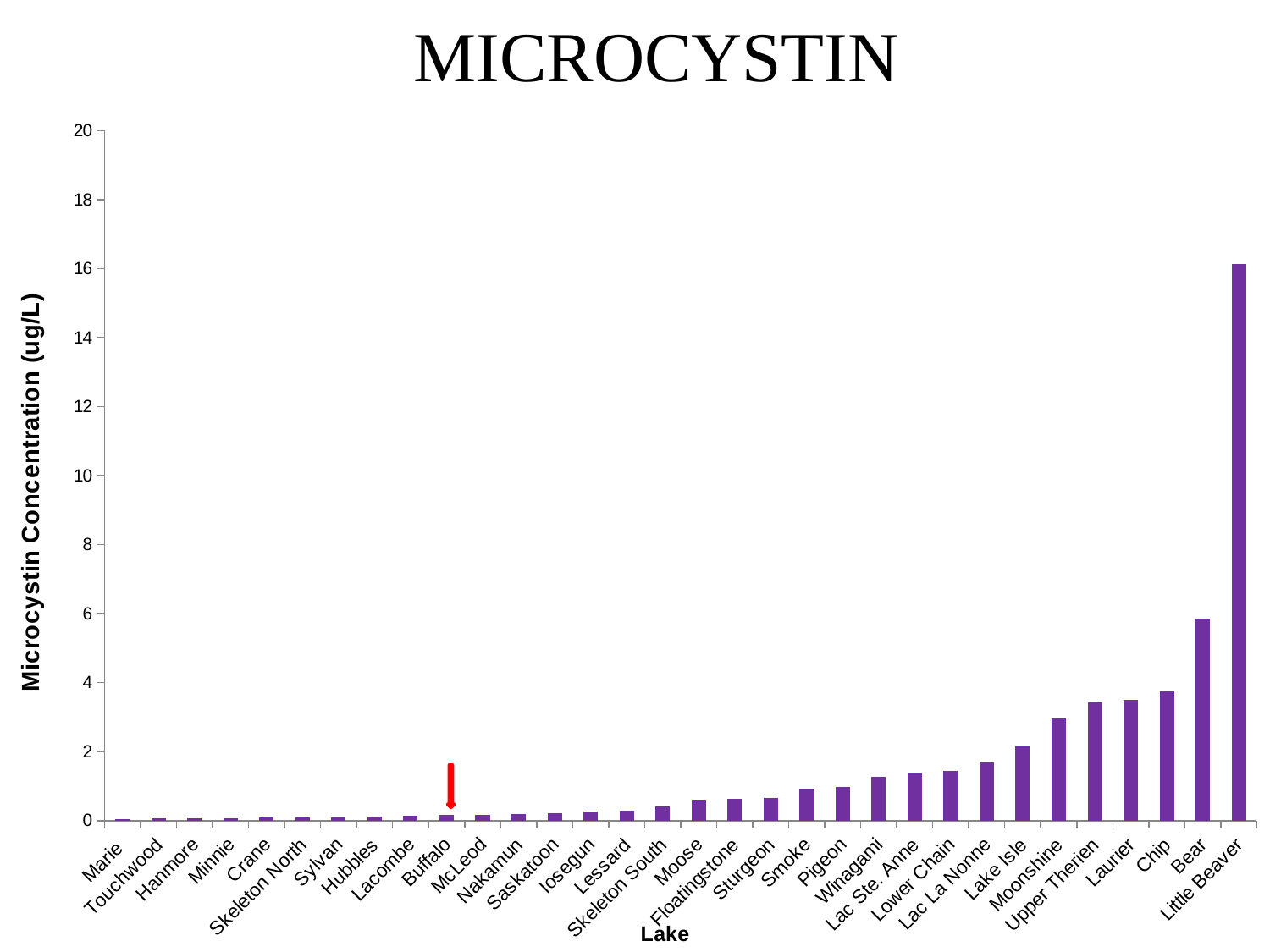
Is the value for Moonshine greater or less than 2? greater How many lakes are shown on the x axis? 32 Is the value for Bear greater or less than 4? greater Is the value for Little Beaver greater or less than 14? greater What kind of chart is shown on the slide? bar chart Do the bar values rise or fall from left to right along the x axis? rise Which has a higher microcystin concentration, Bear or Chip? Bear Which has a higher microcystin concentration, Lake Isle or Pigeon? Lake Isle Which lake has the highest microcystin concentration? Little Beaver Which lake has the second-highest microcystin concentration? Bear Which lake does the red arrow point to? Buffalo